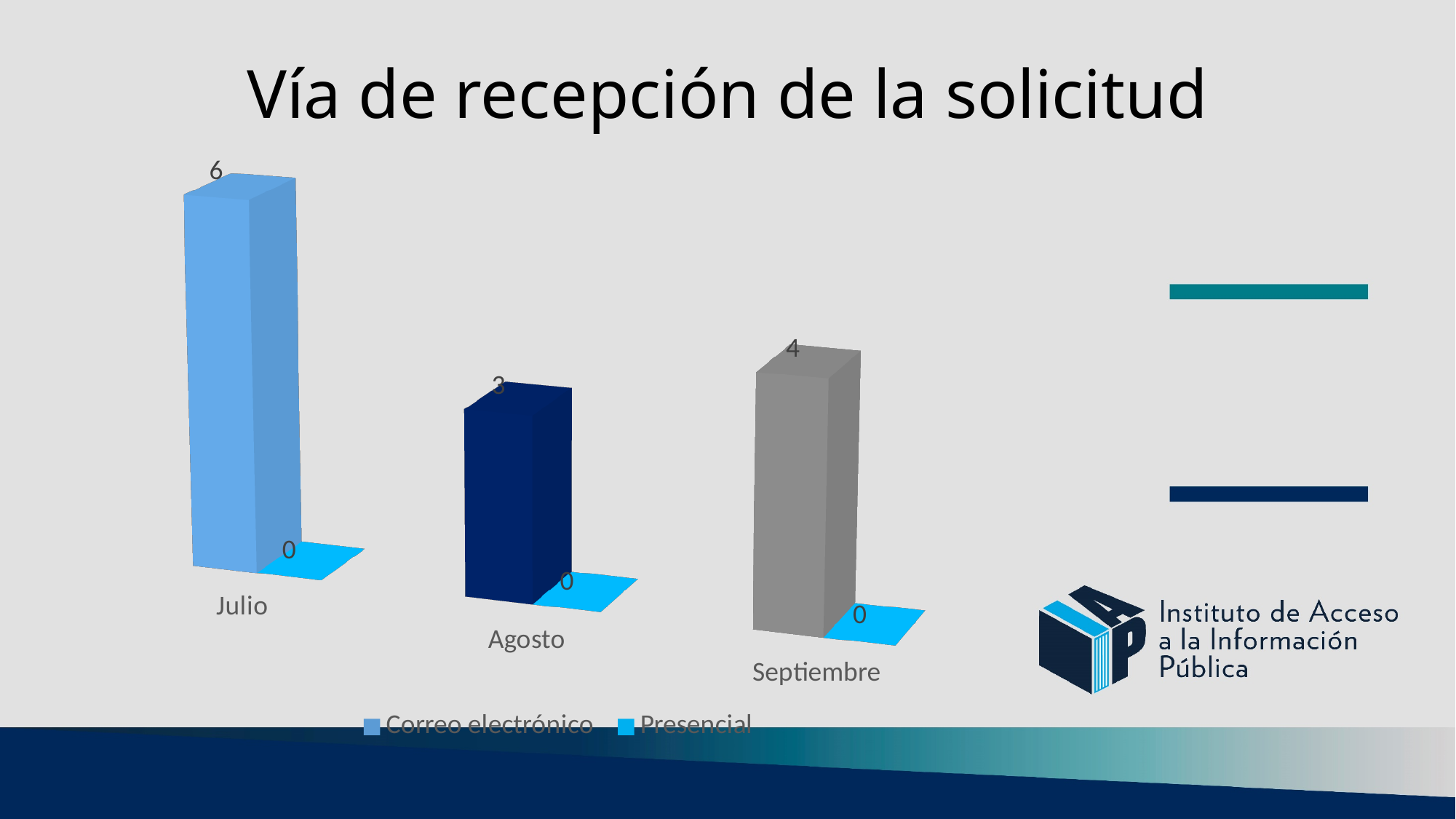
What is the value for Correo electrónico in Julio? 6 Which month has the lowest value for Correo electrónico? Agosto What is the value for Correo electrónico in Septiembre? 4 What is the difference between the Correo electrónico values for Julio and Agosto? 3 How many series does the legend list? 2 What is the value for Presencial in Julio? 0 Which month has the highest value for Correo electrónico? Julio What kind of chart is shown on the slide? Bar chart What is the title of the chart? Vía de recepción de la solicitud How many months are shown on the chart? 3 Which is larger, the Correo electrónico value for Septiembre or for Agosto? Septiembre What is the value for Correo electrónico in Agosto? 3